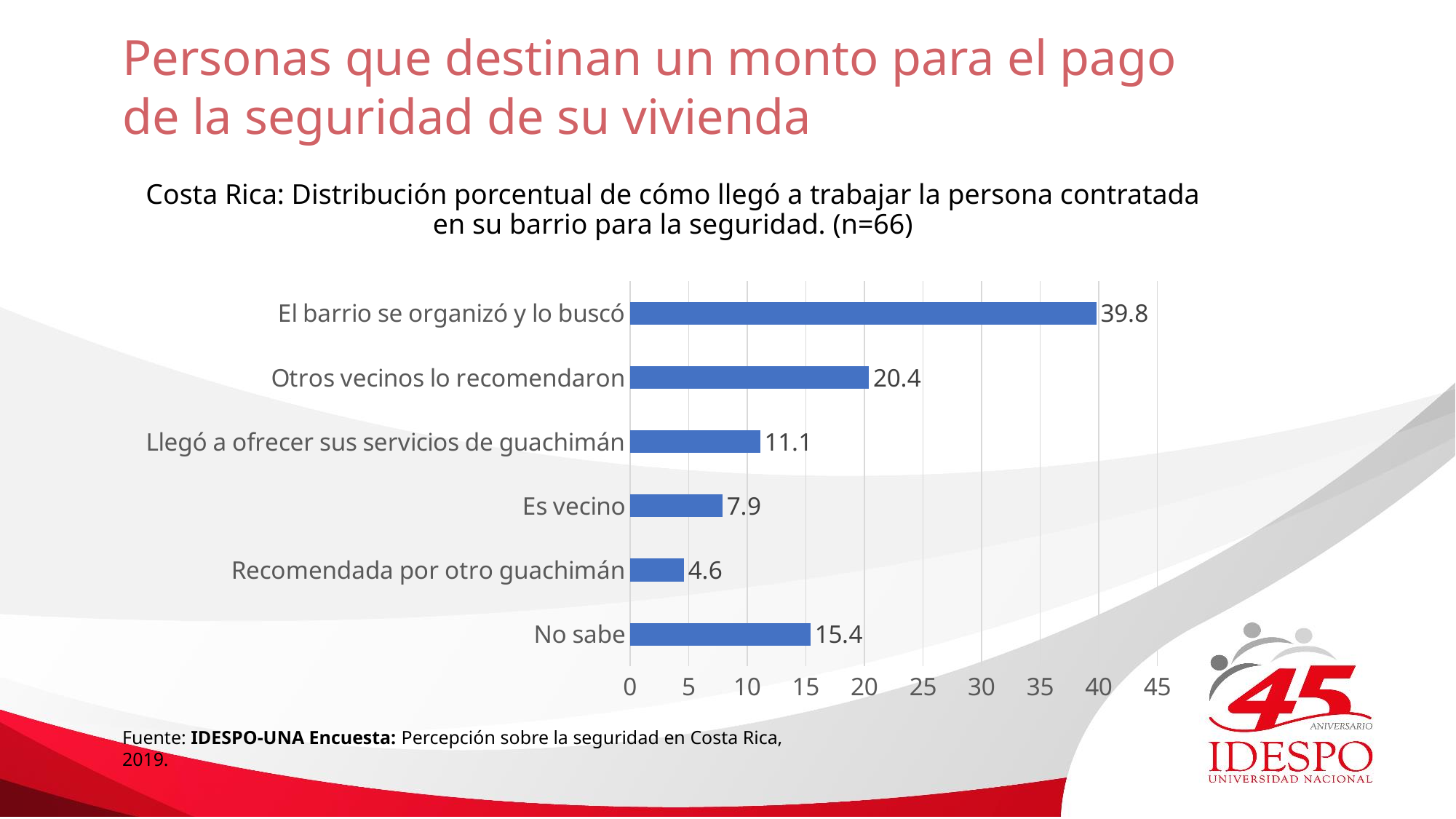
What is the value for "No sabe"? 15.4 What kind of chart is shown on the slide? Bar chart What is the value for "El barrio se organizó y lo buscó"? 39.8 What is the difference between "El barrio se organizó y lo buscó" and "Otros vecinos lo recomendaron"? 19.4 What is the sample size (n) stated in the chart title? 66 Which is larger, "Llegó a ofrecer sus servicios de guachimán" or "No sabe"? No sabe Is the value for "Recomendada por otro guachimán" greater or less than 5? less Which category has the highest value? El barrio se organizó y lo buscó What is the value for "Otros vecinos lo recomendaron"? 20.4 How many categories are shown in the chart? 6 Which category has the lowest value? Recomendada por otro guachimán What is the value for "Es vecino"? 7.9